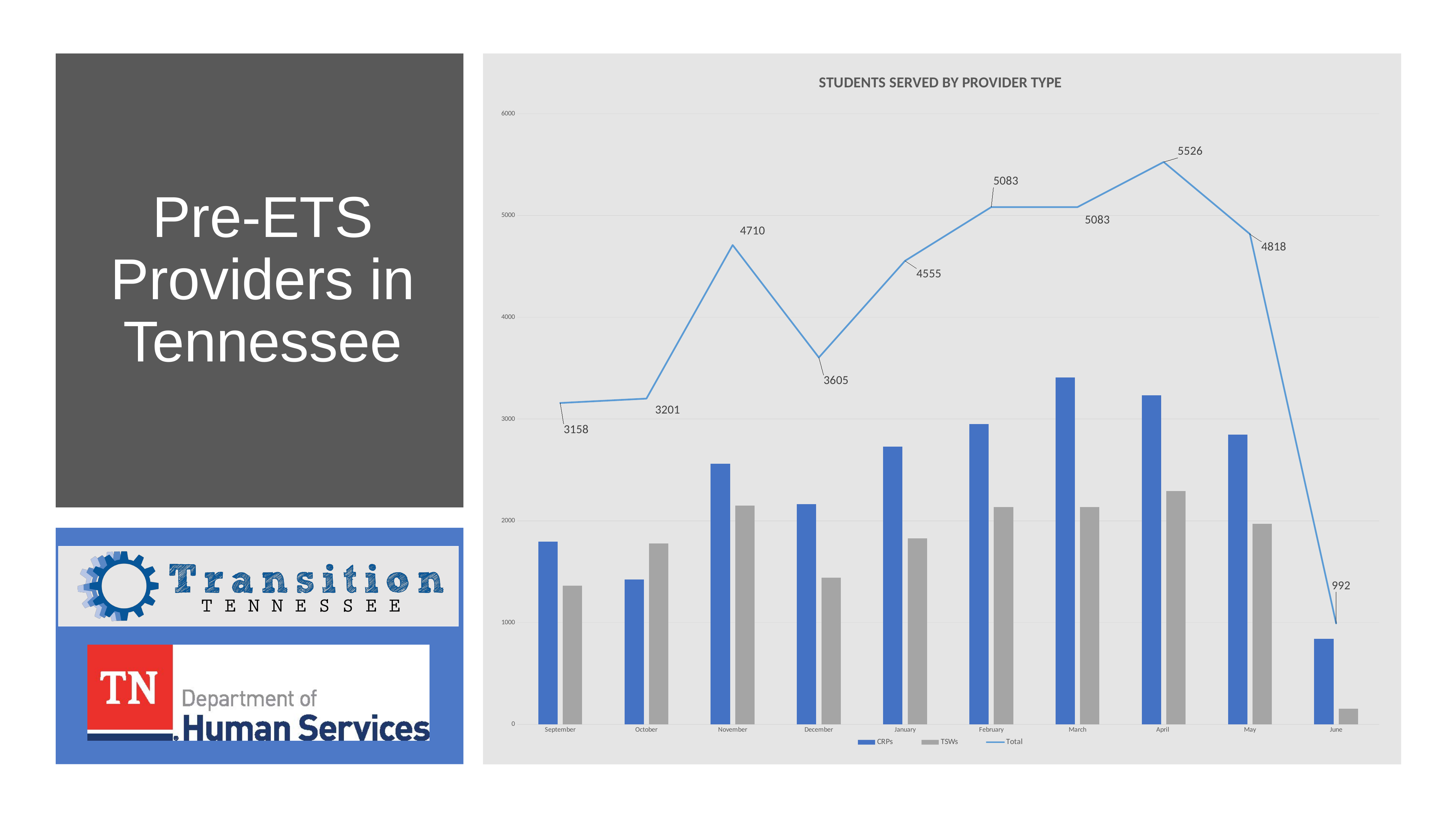
How many months are shown on the x axis? 10 What is the difference between the Total values for November and December? 1105 How many series does the legend list? 3 Does the Total line rise or fall from April to June? fall Which is larger, the Total for January or the Total for May? May What is the Total value for December? 3605 What is the Total value for April? 5526 Which month has the highest Total value? April Is the CRPs value for March greater or less than 3000? greater What is the Total value for June? 992 Which month has the lowest Total value? June Is the TSWs value for September greater or less than 2000? less